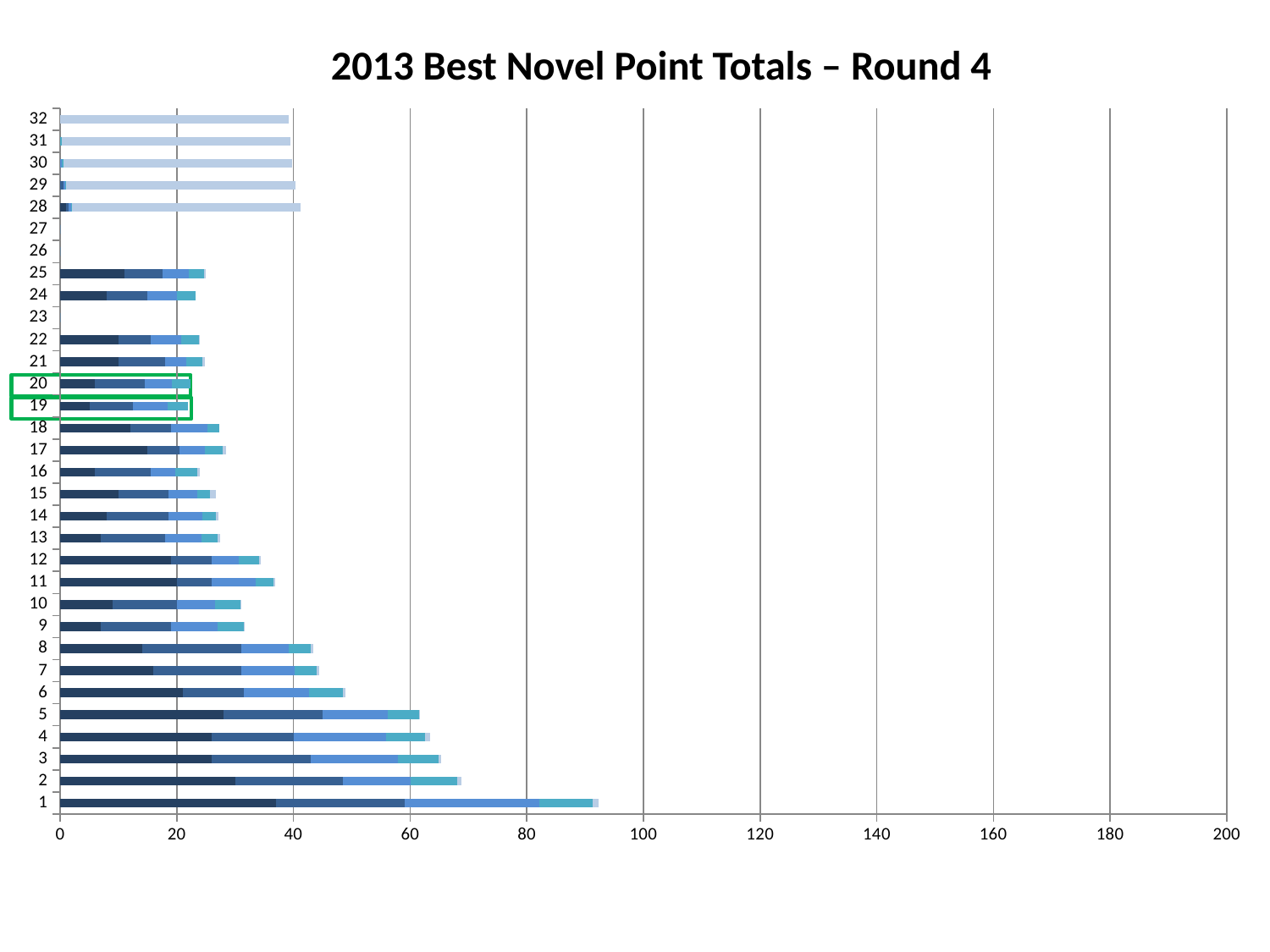
Which two categories are outlined with green boxes on the chart? 19 and 20 Is the total bar length for category 12 greater or less than 40? less Is the total bar length for category 25 greater or less than 20? greater Which has the longer bar, category 5 or category 6? 5 How many categories are listed on the vertical axis of the chart? 32 Which category has the longest bar in the chart? 1 What kind of chart is shown on the slide? Stacked bar chart What is the title of the chart? 2013 Best Novel Point Totals – Round 4 Is the total bar length for category 6 greater or less than 40? greater Which has the longer bar, category 8 or category 12? 8